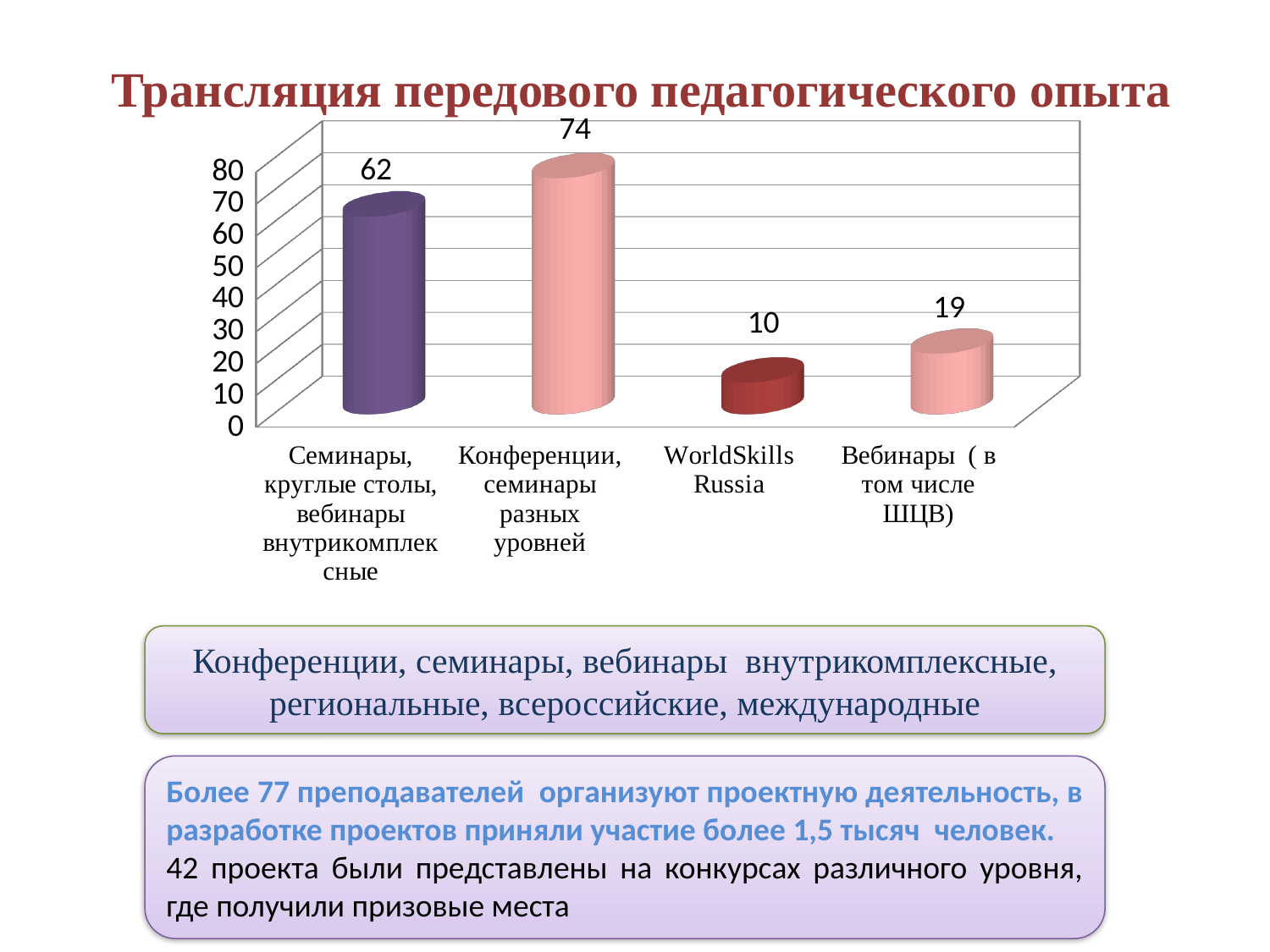
What is the difference between the values for Вебинары (в том числе ШЦВ) and WorldSkills Russia? 9 What is the value for Вебинары (в том числе ШЦВ)? 19 What is the difference between the values for Конференции, семинары разных уровней and Семинары, круглые столы, вебинары внутрикомплексные? 12 How many categories are shown in the chart? 4 What is the value for Семинары, круглые столы, вебинары внутрикомплексные? 62 What kind of chart is shown on the slide? bar chart Which category has the lowest value? WorldSkills Russia What is the value for Конференции, семинары разных уровней? 74 Which category has the highest value? Конференции, семинары разных уровней What is the title of the slide above the chart? Трансляция передового педагогического опыта What is the value for WorldSkills Russia? 10 Which is larger: the value for Семинары, круглые столы, вебинары внутрикомплексные or the value for Вебинары (в том числе ШЦВ)? Семинары, круглые столы, вебинары внутрикомплексные